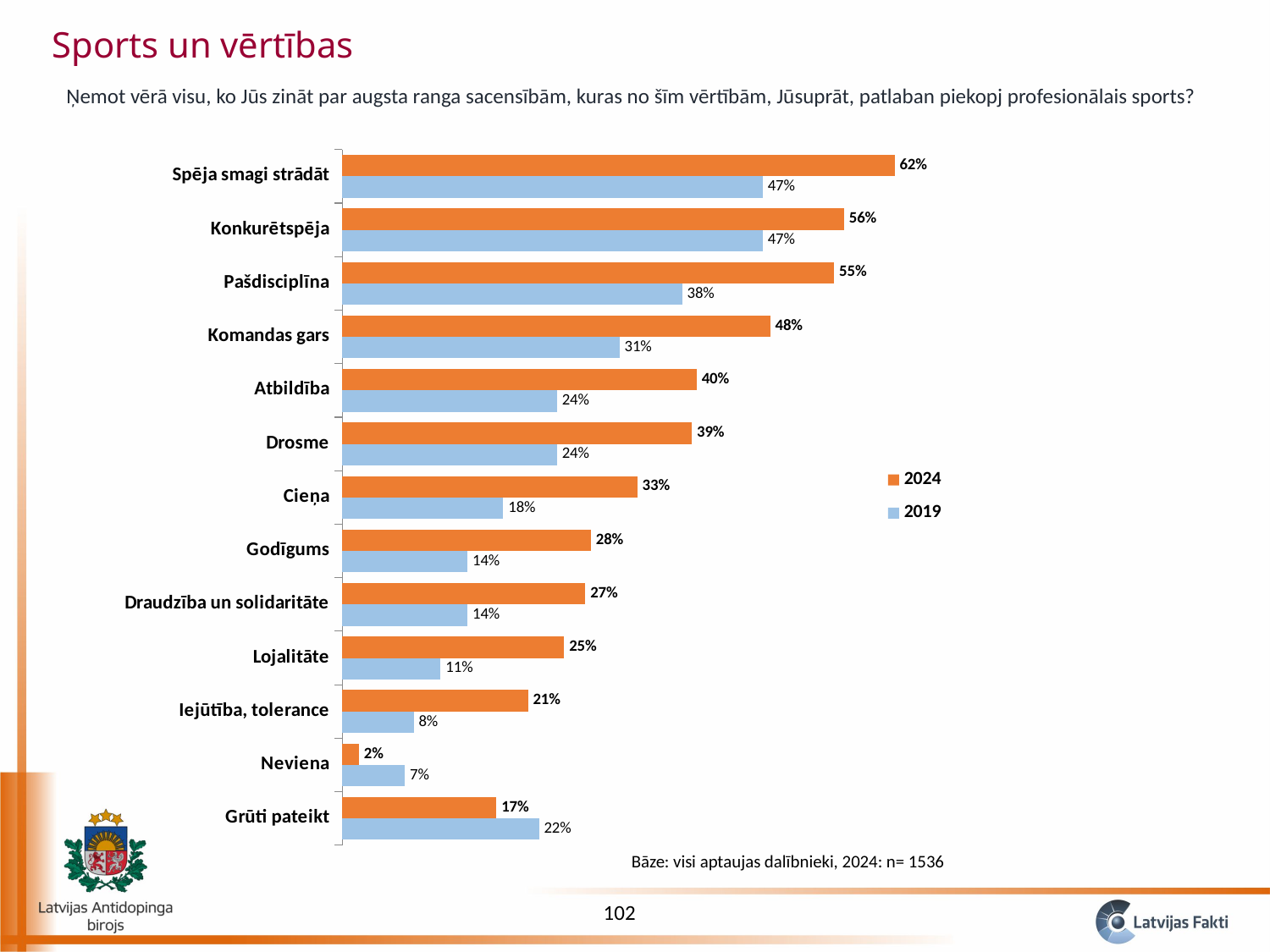
Which is larger for Grūti pateikt, the 2024 value or the 2019 value? 2019 How many series does the legend list? 2 What is the 2019 value for Pašdisciplīna? 38% What is the 2024 value for Lojalitāte? 25% What is the difference between the 2024 and 2019 values for Komandas gars? 17% What kind of chart is shown on the slide? Bar chart How many categories are shown on the chart? 13 Which series is shown in orange? 2024 Which category has the highest 2024 value? Spēja smagi strādāt What is the 2024 value for Spēja smagi strādāt? 62% What is the difference between the 2024 values for Konkurētspēja and Pašdisciplīna? 1% Which category has the lowest 2024 value? Neviena